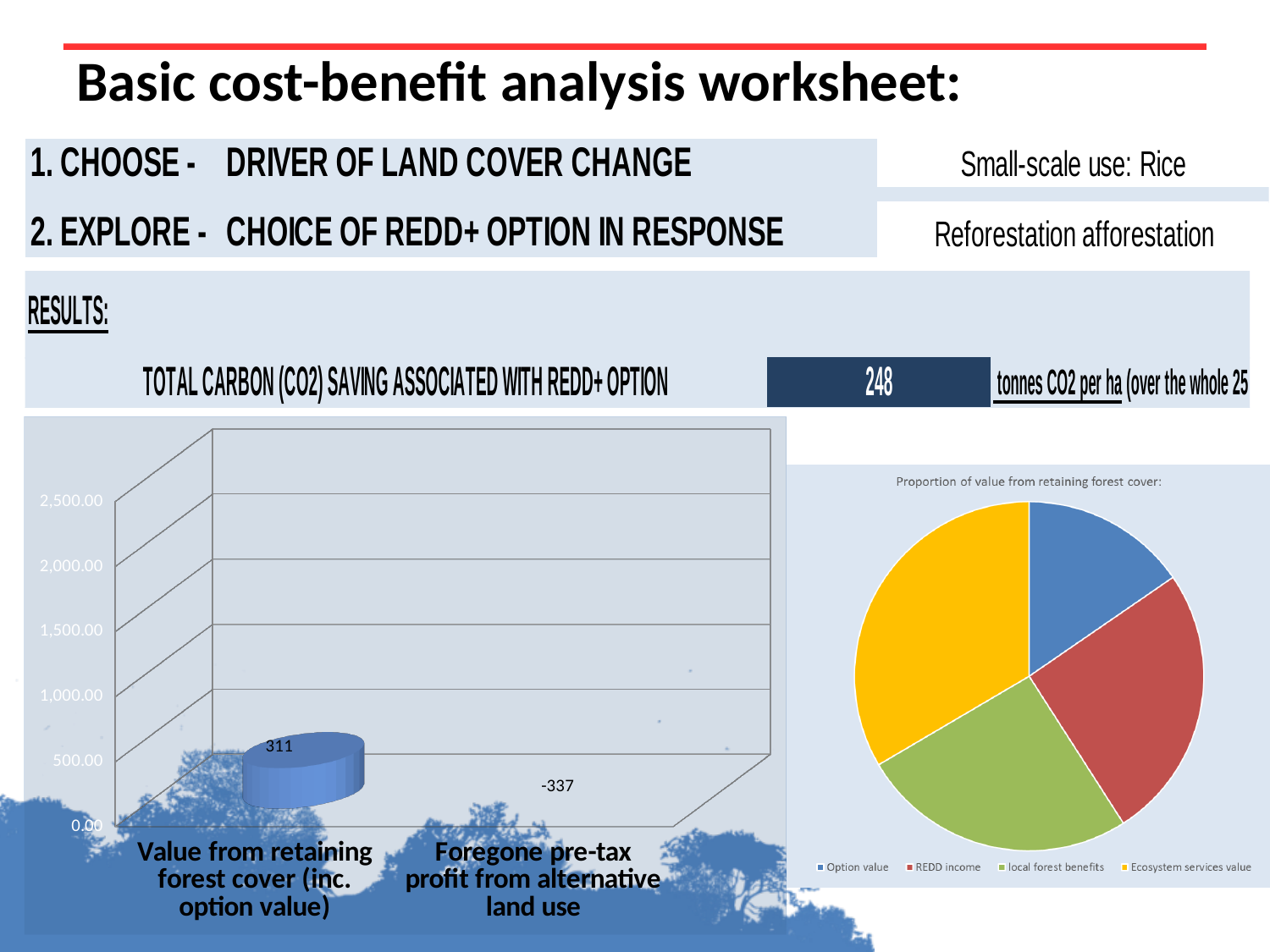
How many categories are shown in the bar chart? 2 In the bar chart, what is the value for 'Foregone pre-tax profit from alternative land use'? -337 In the bar chart, what is the difference between the value for 'Value from retaining forest cover (inc. option value)' and the value for 'Foregone pre-tax profit from alternative land use'? 648 In the bar chart, which category has the highest value? Value from retaining forest cover (inc. option value) In the pie chart 'Proportion of value from retaining forest cover:', which slice is the smallest? Option value In the bar chart, which category has the lowest value? Foregone pre-tax profit from alternative land use What kind of chart is the chart titled 'Proportion of value from retaining forest cover:'? pie chart What kind of chart is the chart on the left of the slide? bar chart In the bar chart, what is the value for 'Value from retaining forest cover (inc. option value)'? 311 How many entries does the legend of the pie chart 'Proportion of value from retaining forest cover:' list? 4 In the bar chart, is the value for 'Value from retaining forest cover (inc. option value)' greater or less than 500.00? less In the pie chart 'Proportion of value from retaining forest cover:', which slice is the largest? Ecosystem services value